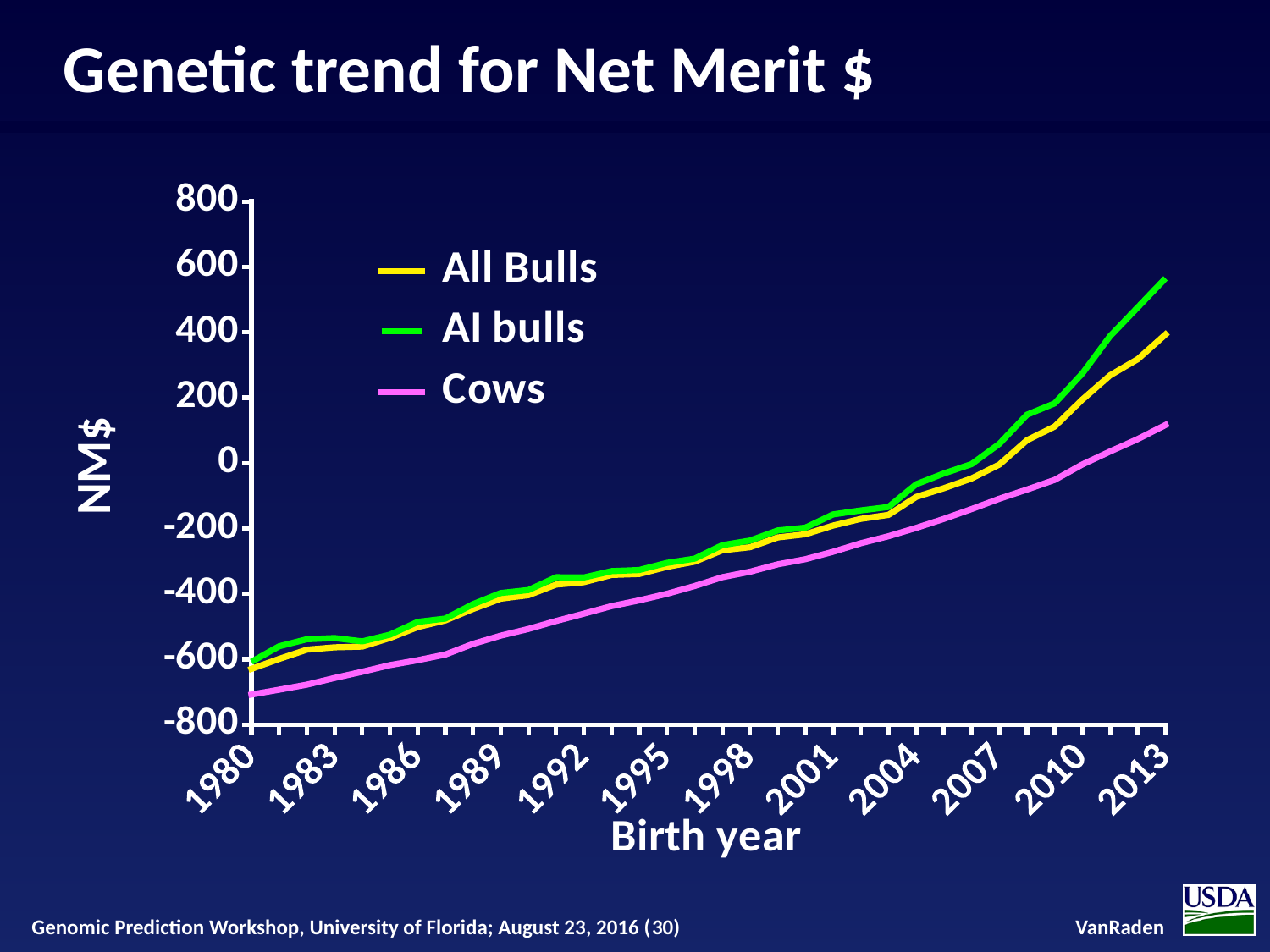
What is the label of the x axis? Birth year What is the title of the chart? Genetic trend for Net Merit $ Which series has the highest value at birth year 2013? AI bulls Do the values for Cows rise or fall across the birth years? rise Is the value for Cows in 2007 greater or less than 0? less What kind of chart is shown on the slide? line chart Is the value for Cows in 1980 greater or less than -600? less How many series does the legend list? 3 At birth year 2013, which is larger: the value for AI bulls or the value for All Bulls? AI bulls Do the values for AI bulls rise or fall from 1980 to 2013? rise Is the value for AI bulls in 2013 greater or less than 400? greater Which series has the lowest value at birth year 2013? Cows